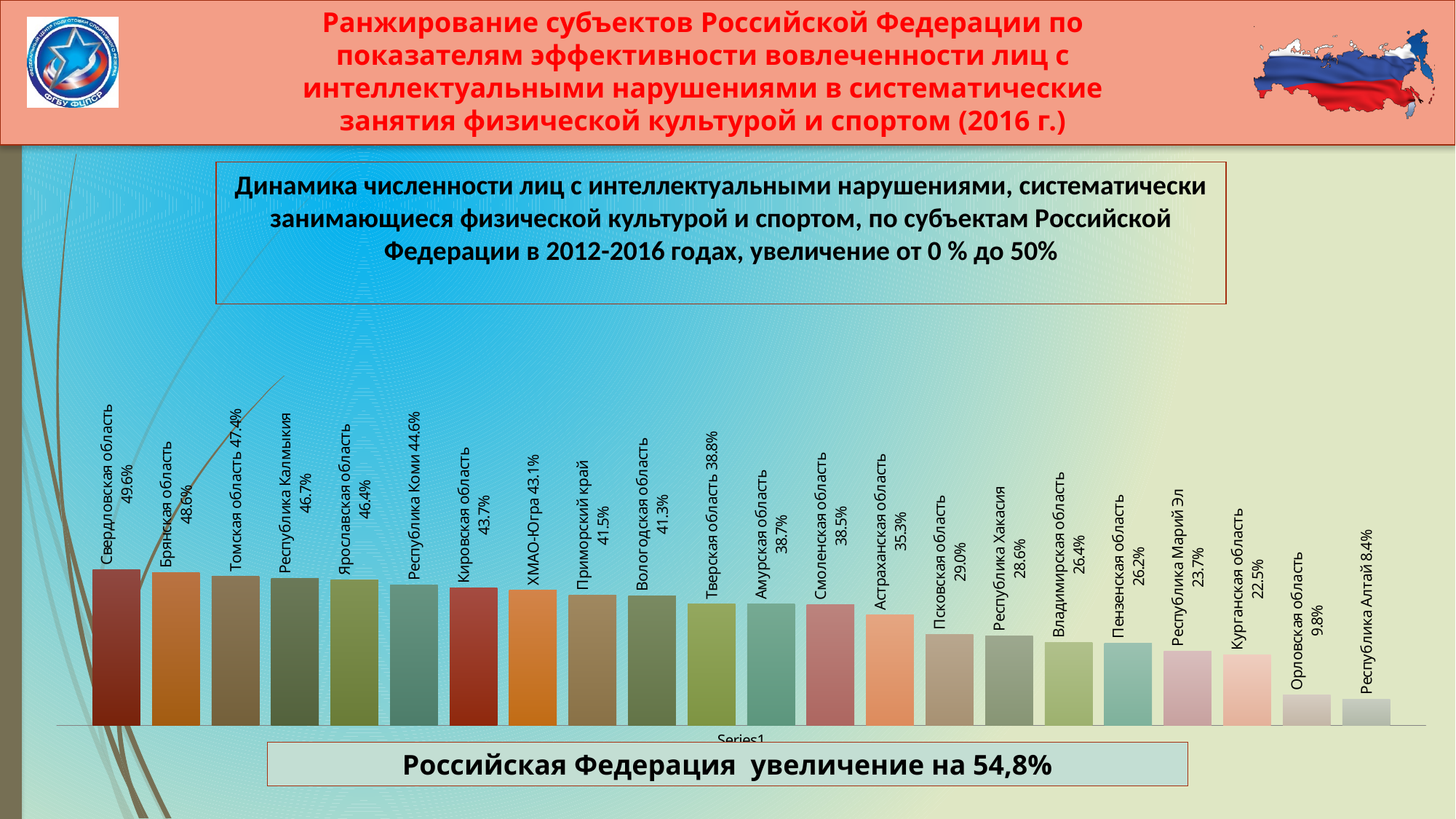
What value is shown for Свердловская область? 49.6% What is the difference between the values for Свердловская область and Республика Алтай? 41.2% What kind of chart is shown on the slide? Bar chart Which has a larger value, Кировская область or Курганская область? Кировская область What value is shown for Республика Коми? 44.6% Which region has the highest value in the chart? Свердловская область Which region has the lowest value in the chart? Республика Алтай What is the difference between the values for Псковская область and Республика Хакасия? 0.4% What value is shown for Орловская область? 9.8% What value is shown for Астраханская область? 35.3% How many regions (bars) are shown in the chart? 22 Do the values rise or fall from left to right across the chart? Fall